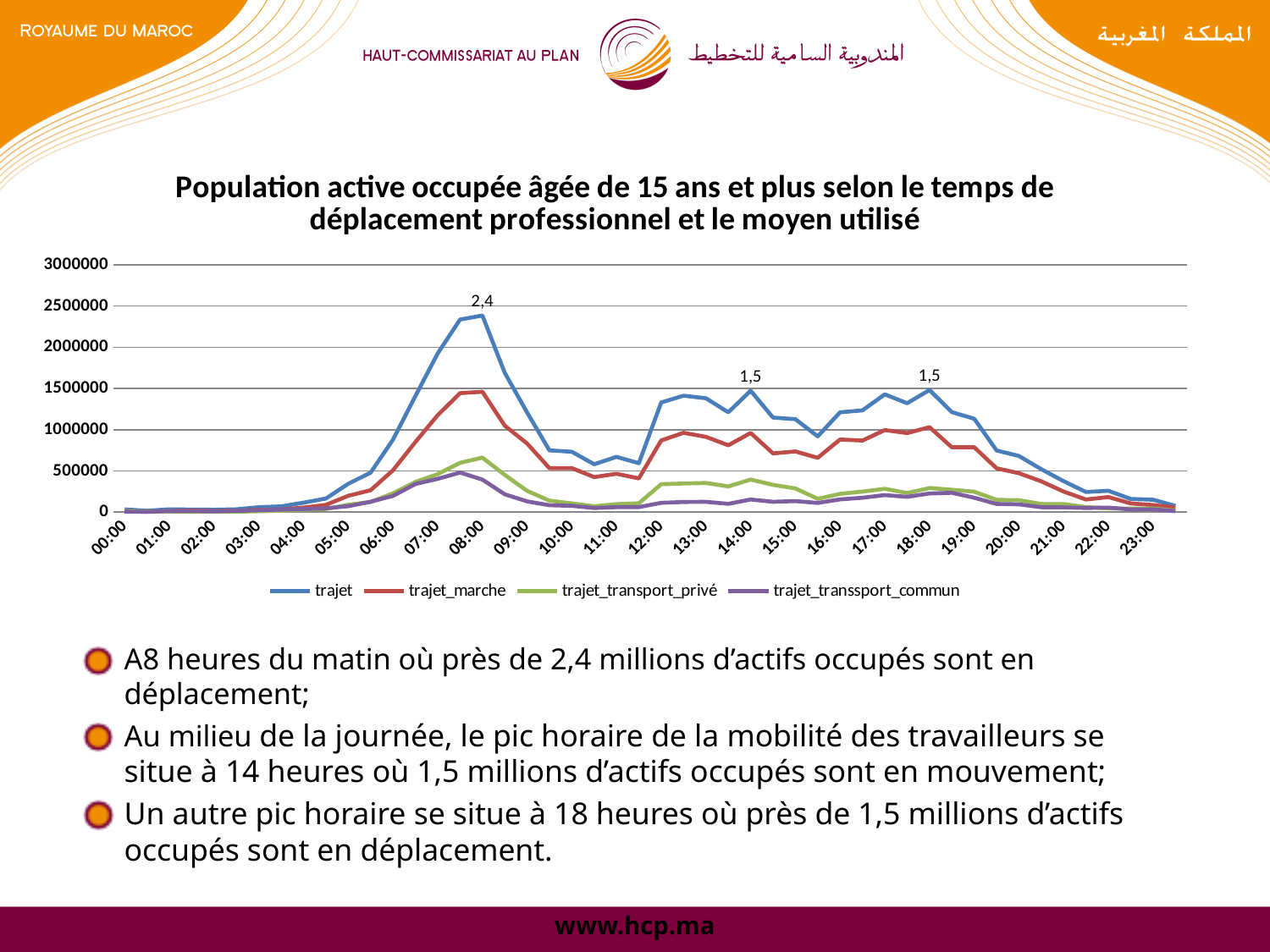
Is the value of the trajet series at 08:00 greater or less than 2000000? greater What data label is printed at the 18:00 peak of the trajet series? 1,5 What colour is the trajet series line in the legend? blue At 14:00, which is larger: trajet_marche or trajet_transport_privé? trajet_marche Does the trajet series rise or fall between 08:00 and 10:00? fall Is the value of the trajet_transport_privé series at 08:00 greater or less than 1000000? less What kind of chart is shown on the slide? line chart How many series does the legend list? 4 What data label is printed at the 14:00 peak of the trajet series? 1,5 What data label is printed at the 08:00 peak of the trajet series? 2,4 Which series reaches the highest value at 08:00? trajet Is the value of the trajet_marche series at 08:00 greater or less than 1000000? greater